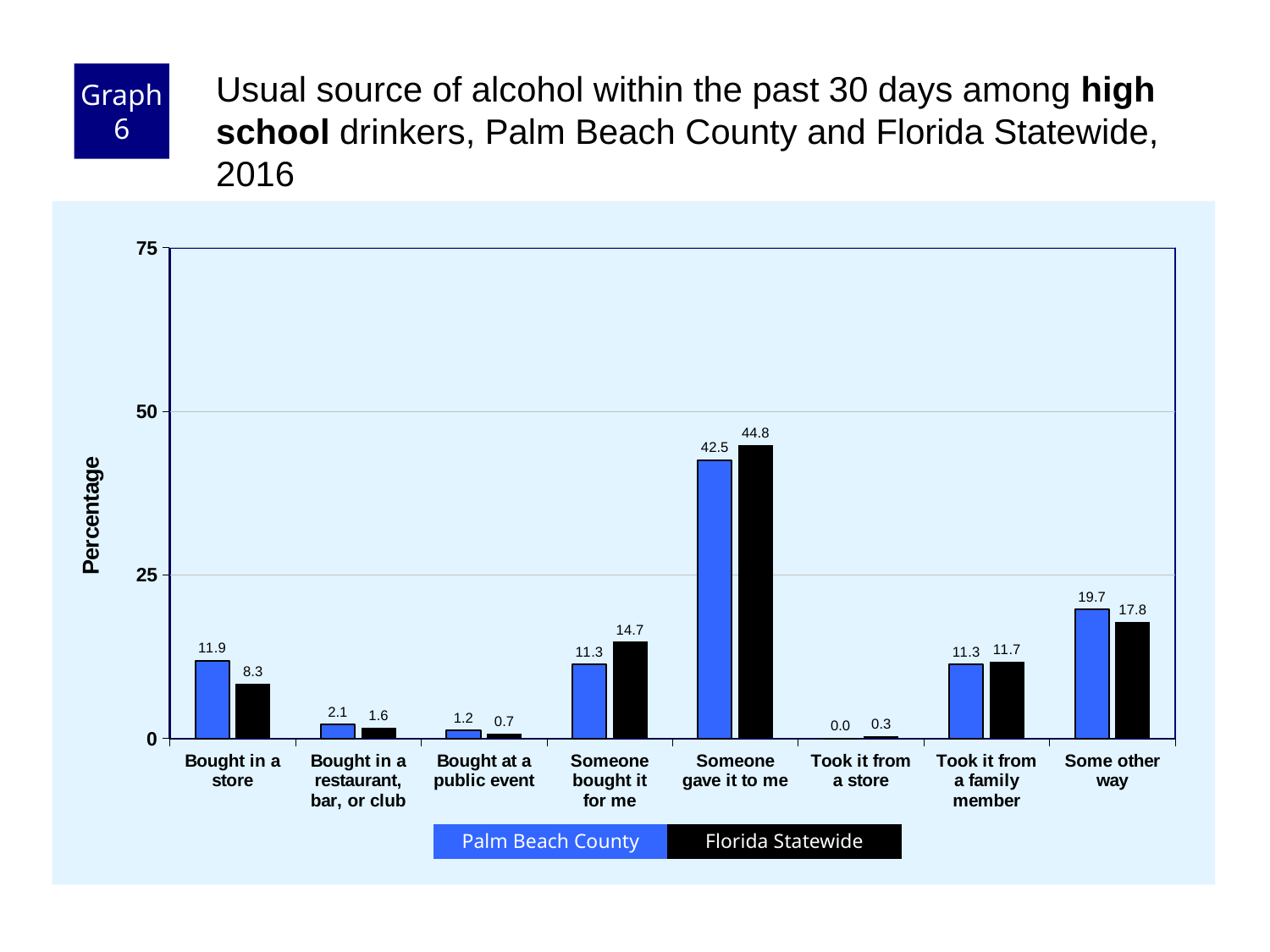
How many series does the legend list? 2 For "Some other way", which is larger: Palm Beach County or Florida Statewide? Palm Beach County Is the Florida Statewide value for "Someone gave it to me" greater or less than 50? less What is the difference between the Florida Statewide and Palm Beach County values for "Someone bought it for me"? 3.4 How many categories are shown on the x axis? 8 What is the Palm Beach County value for "Someone gave it to me"? 42.5 What is the Florida Statewide value for "Took it from a store"? 0.3 What is the label of the y axis? Percentage Which category has the highest Florida Statewide value? Someone gave it to me Which category has the lowest Palm Beach County value? Took it from a store What kind of chart is shown on the slide? bar chart What is the Florida Statewide value for "Bought in a store"? 8.3